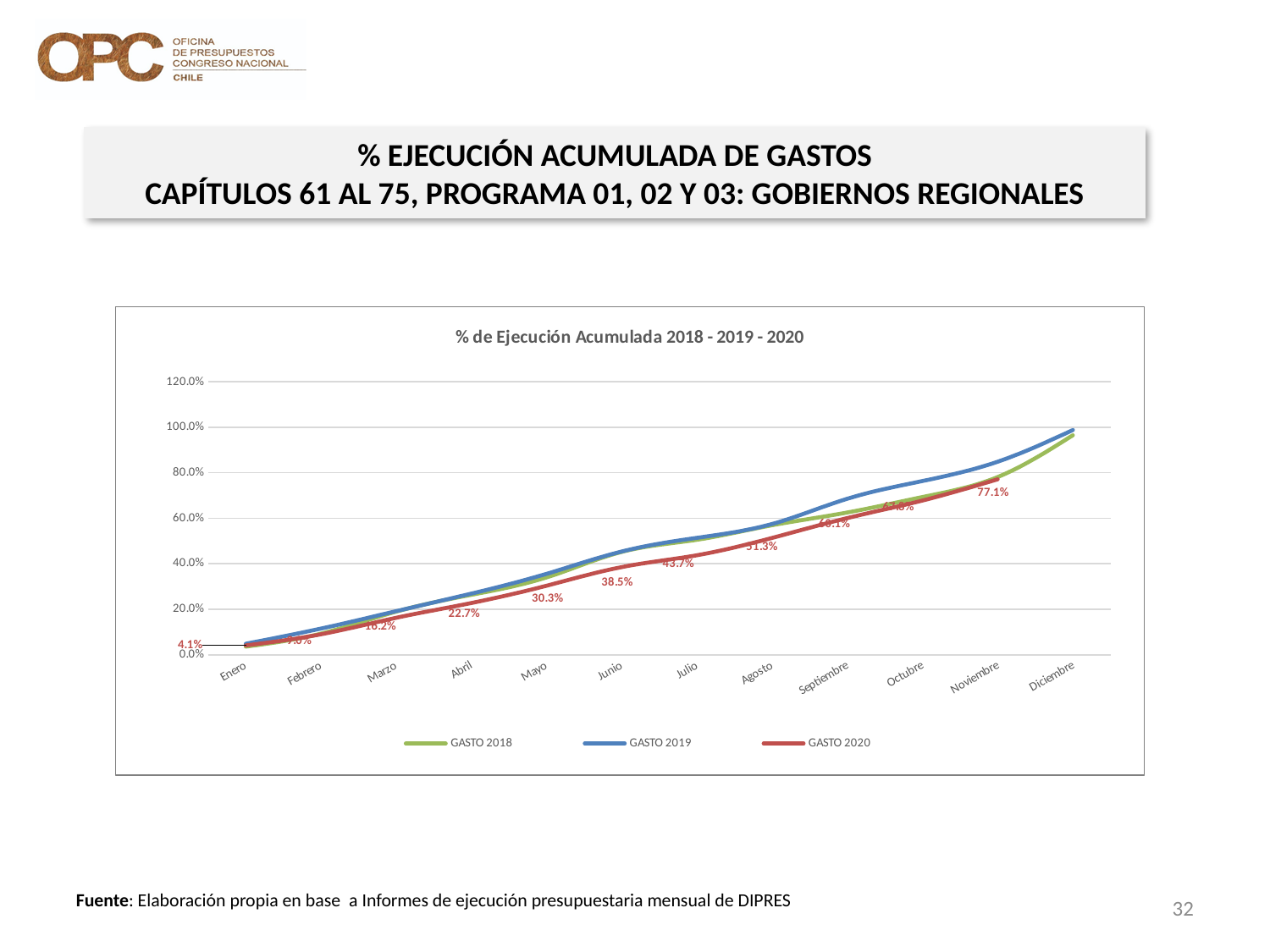
What is the GASTO 2020 value for Noviembre? 77.1% What is the GASTO 2020 value for Abril? 22.7% What is the GASTO 2020 value for Junio? 38.5% What kind of chart is shown on the slide? line chart Does the GASTO 2020 line rise or fall from Enero to Noviembre? rise What is the GASTO 2020 value for Enero? 4.1% Is the GASTO 2019 value for Diciembre greater or less than 80.0%? greater How many months are shown on the x axis? 12 How many series does the chart legend list? 3 By how many percentage points does GASTO 2020 increase from Abril to Mayo? 7.6 What is the GASTO 2020 value for Marzo? 16.2% By how many percentage points does GASTO 2020 increase from Agosto to Noviembre? 25.8